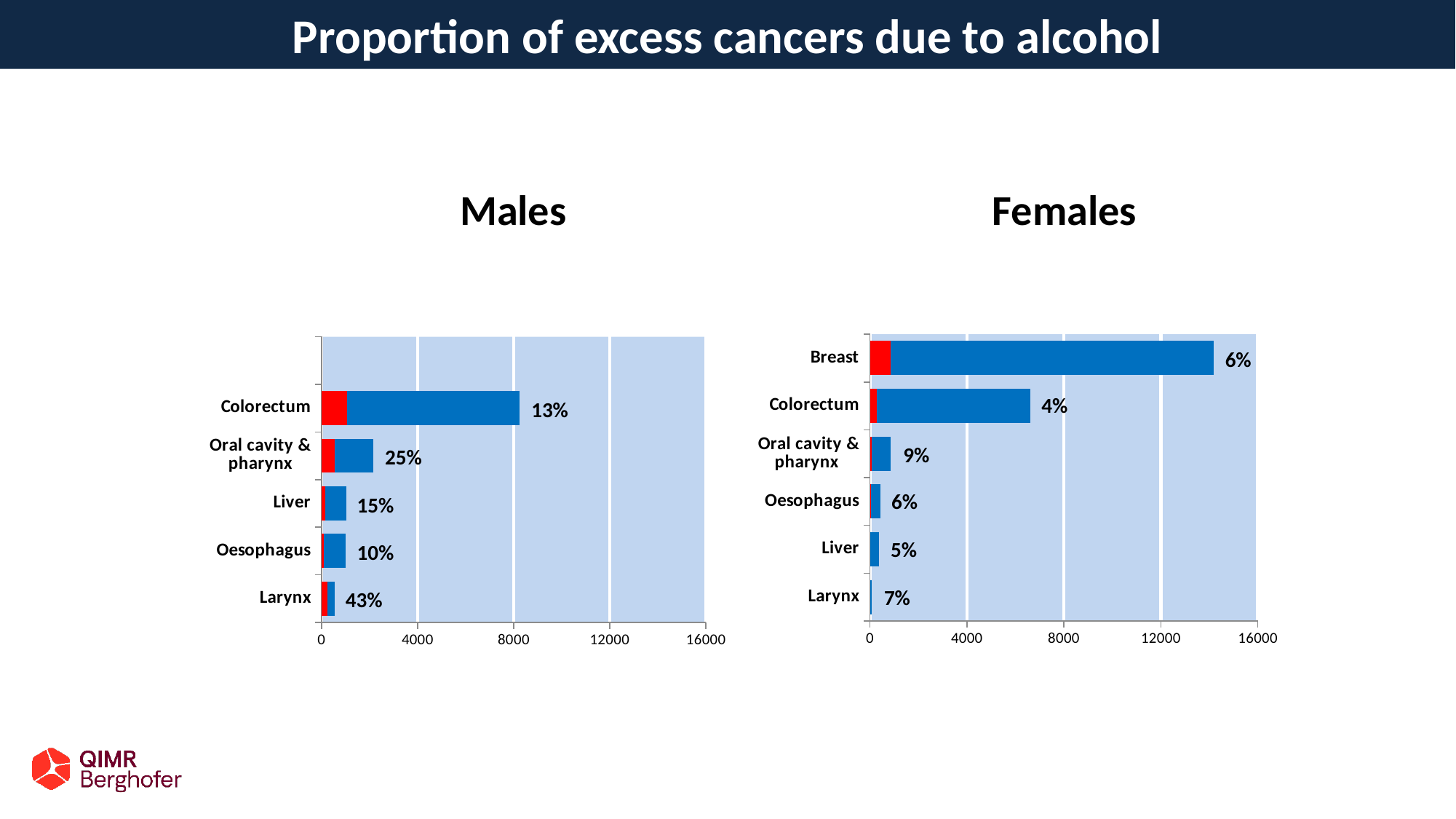
In the Females chart, which category has the longest bar? Breast In the Males chart, what percentage label is shown for Larynx? 43% In the Females chart, what percentage label is shown for Oral cavity & pharynx? 9% In the Females chart, which category has the shortest bar? Larynx In the Males chart, is the total bar length for Colorectum greater or less than 8000? greater What kind of chart is the Males chart? Bar chart How many labelled categories does the Females chart show? 6 In the Females chart, is the total bar length for Breast greater or less than 12000? greater In the Males chart, which category has the longest bar? Colorectum In the Males chart, what percentage label is shown for Oral cavity & pharynx? 25% In the Females chart, what percentage label is shown for Breast? 6% In the Males chart, which percentage label is higher, Larynx or Colorectum? Larynx